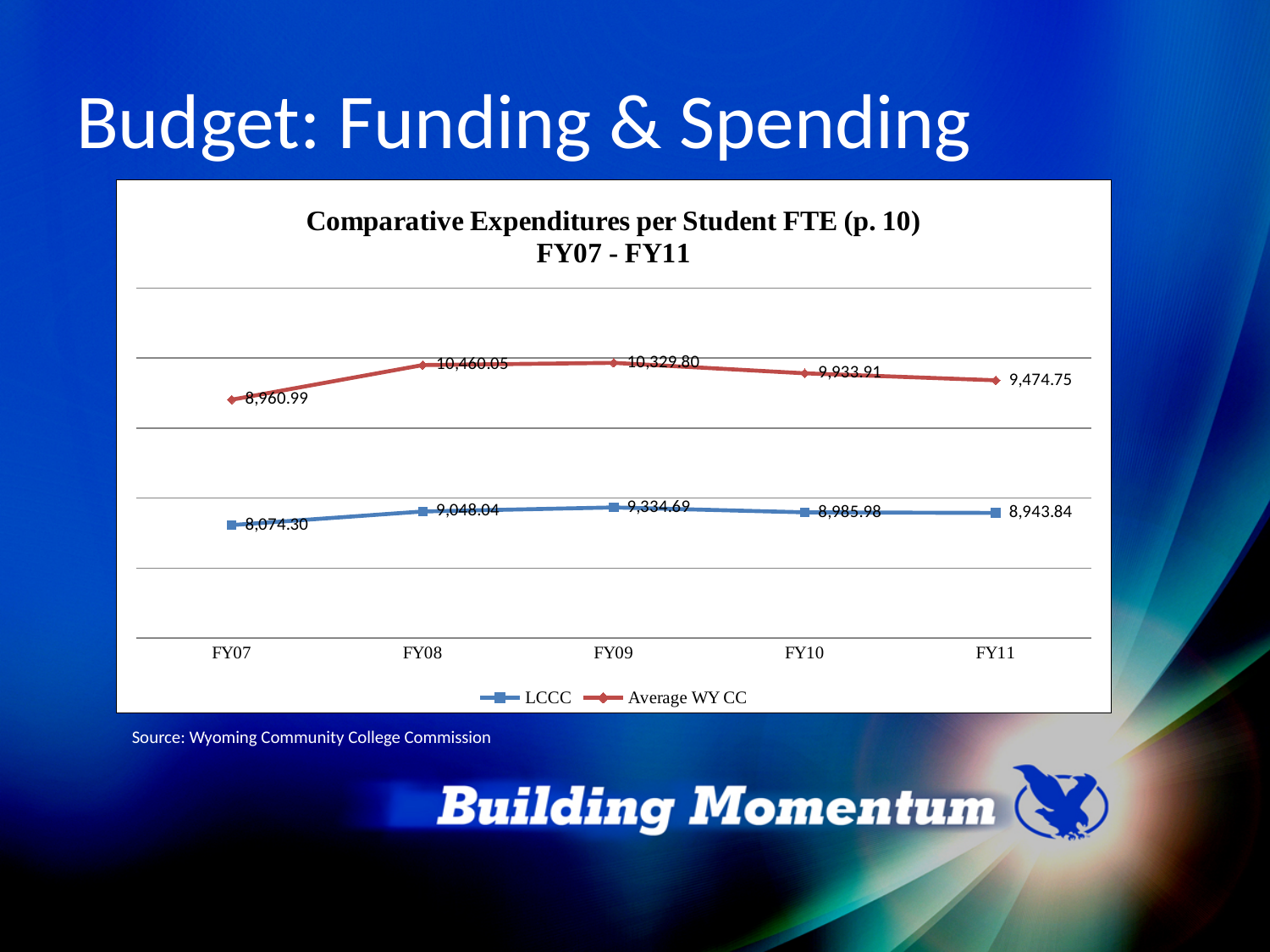
How many fiscal years are shown on the x axis? 5 What is the LCCC value for FY09? 9,334.69 What is the Average WY CC value for FY11? 9,474.75 What is the difference between the Average WY CC and LCCC values in FY09? 995.11 Which is larger in FY10, the LCCC value or the Average WY CC value? Average WY CC In which fiscal year is the Average WY CC value highest? FY08 What is the Average WY CC value for FY08? 10,460.05 What kind of chart is shown? Line chart What is the difference between the Average WY CC and LCCC values in FY11? 530.91 In which fiscal year is the LCCC value lowest? FY07 How many series does the legend list? 2 What is the LCCC value for FY07? 8,074.30